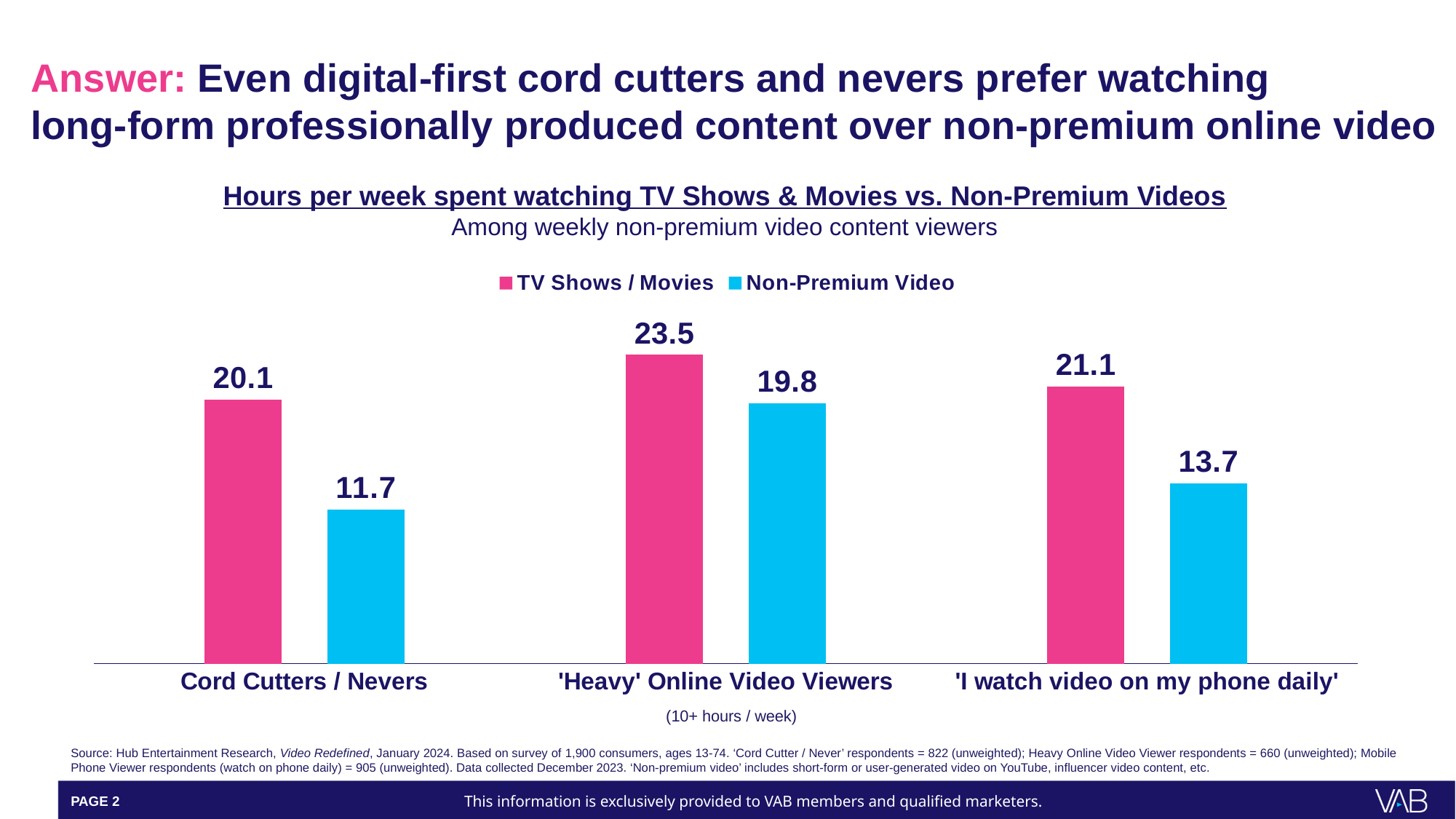
How many categories are shown on the x axis? 3 Which category has the lowest value for Non-Premium Video? Cord Cutters / Nevers What is the value for Non-Premium Video among 'I watch video on my phone daily'? 13.7 Which category has the highest value for TV Shows / Movies? 'Heavy' Online Video Viewers What is the value for TV Shows / Movies among Cord Cutters / Nevers? 20.1 What is the difference between TV Shows / Movies and Non-Premium Video for 'I watch video on my phone daily'? 7.4 What is the difference between TV Shows / Movies and Non-Premium Video for Cord Cutters / Nevers? 8.4 What kind of chart is shown on the slide? Bar chart How many series does the legend list? 2 What colour represents the Non-Premium Video series? Blue Which is larger for 'Heavy' Online Video Viewers: TV Shows / Movies or Non-Premium Video? TV Shows / Movies What is the value for Non-Premium Video among 'Heavy' Online Video Viewers? 19.8